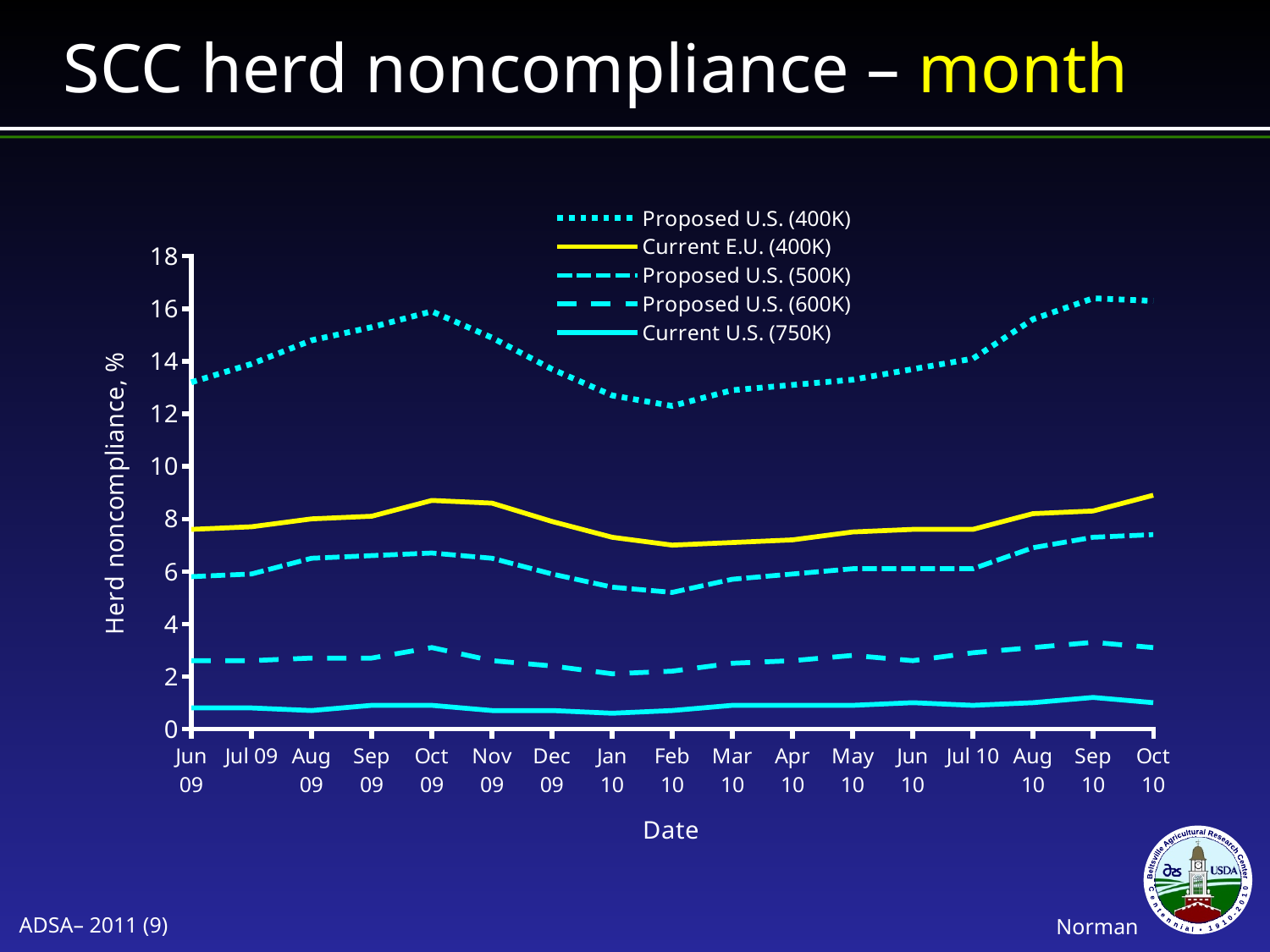
How many months are plotted along the x axis? 17 Which is larger for Proposed U.S. (400K): the value in Oct 09 or the value in Feb 10? Oct 09 Is the value for Current E.U. (400K) in Oct 10 greater or less than 8? greater In which month is the Proposed U.S. (400K) series at its lowest? Feb 10 Which series has the lowest herd noncompliance across the whole period? Current U.S. (750K) Which series has the highest herd noncompliance across the whole period? Proposed U.S. (400K) Is the value for Current U.S. (750K) in Sep 10 greater or less than 2? less What kind of chart is shown on the slide? line chart How many series does the legend list? 5 Is the value for Proposed U.S. (400K) in Oct 09 greater or less than 14? greater Does the Proposed U.S. (400K) series rise or fall from Oct 09 to Feb 10? fall